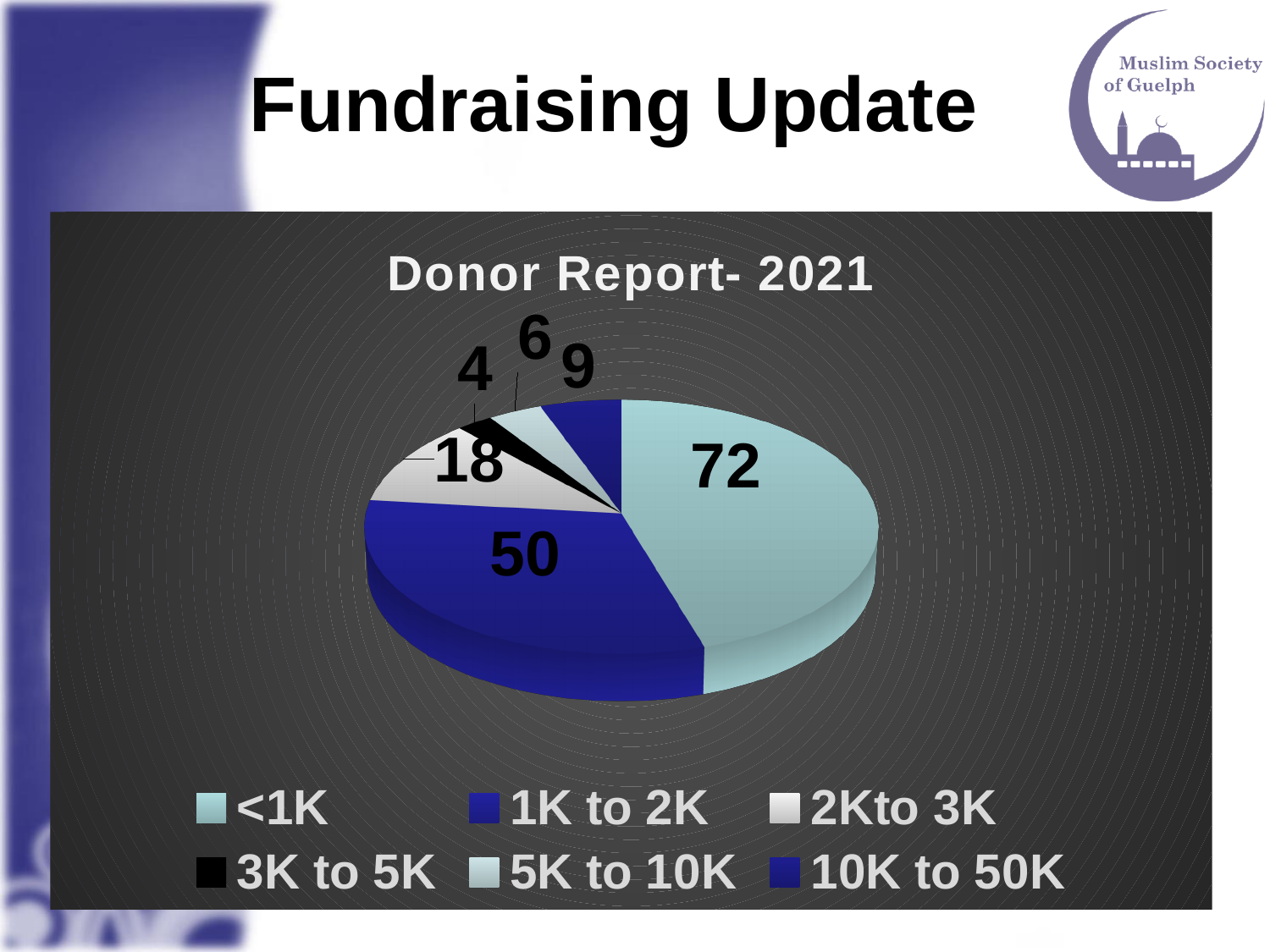
Which is larger, the 5K to 10K value or the 10K to 50K value? 10K to 50K What is the value for the 2K to 3K category? 18 How many categories does the legend list? 6 What is the value for the 1K to 2K category? 50 Which category has the largest slice? <1K What type of chart is shown on the slide? Pie chart Which category has the smallest slice? 3K to 5K What is the value for the <1K category? 72 What is the value for the 10K to 50K category? 9 What is the difference between the <1K and 1K to 2K values? 22 What is the title of the chart? Donor Report- 2021 What is the value for the 3K to 5K category? 4